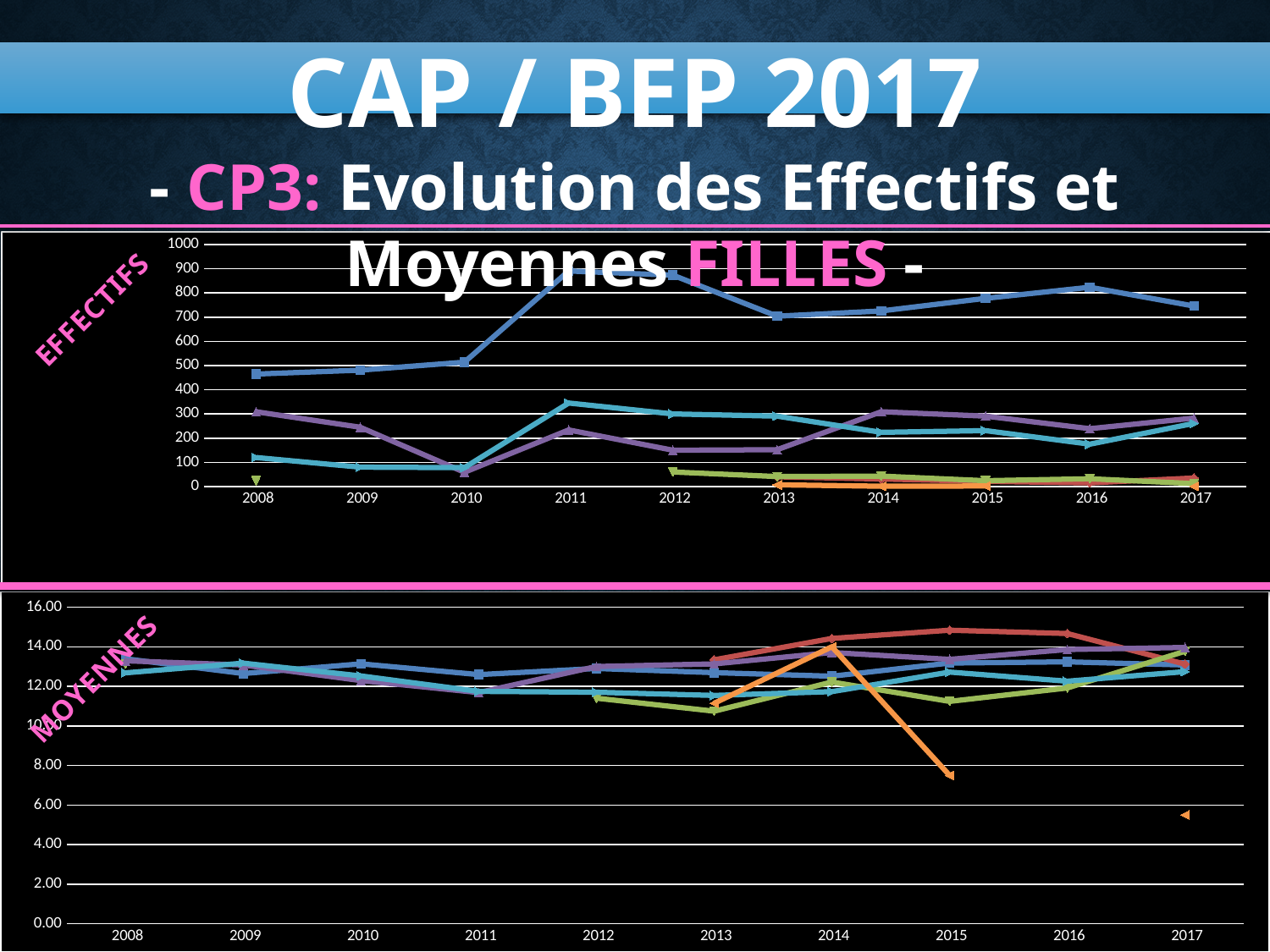
In the top chart (EFFECTIFS), is the value of the light blue line in 2011 greater or less than 300? greater In the top chart (EFFECTIFS), how many years are shown on the x axis? 10 In the bottom chart (MOYENNES), is the value of the red line in 2015 greater or less than 14.00? greater In the top chart (EFFECTIFS), is the value of the dark blue line in 2008 greater or less than 500? less What kind of chart is the bottom chart labelled MOYENNES? line chart In the top chart (EFFECTIFS), in which year is the dark blue line at its lowest? 2008 What kind of chart is the top chart labelled EFFECTIFS? line chart In the bottom chart (MOYENNES), how many years are shown on the x axis? 10 What is the highest value shown on the y axis of the top chart (EFFECTIFS)? 1000